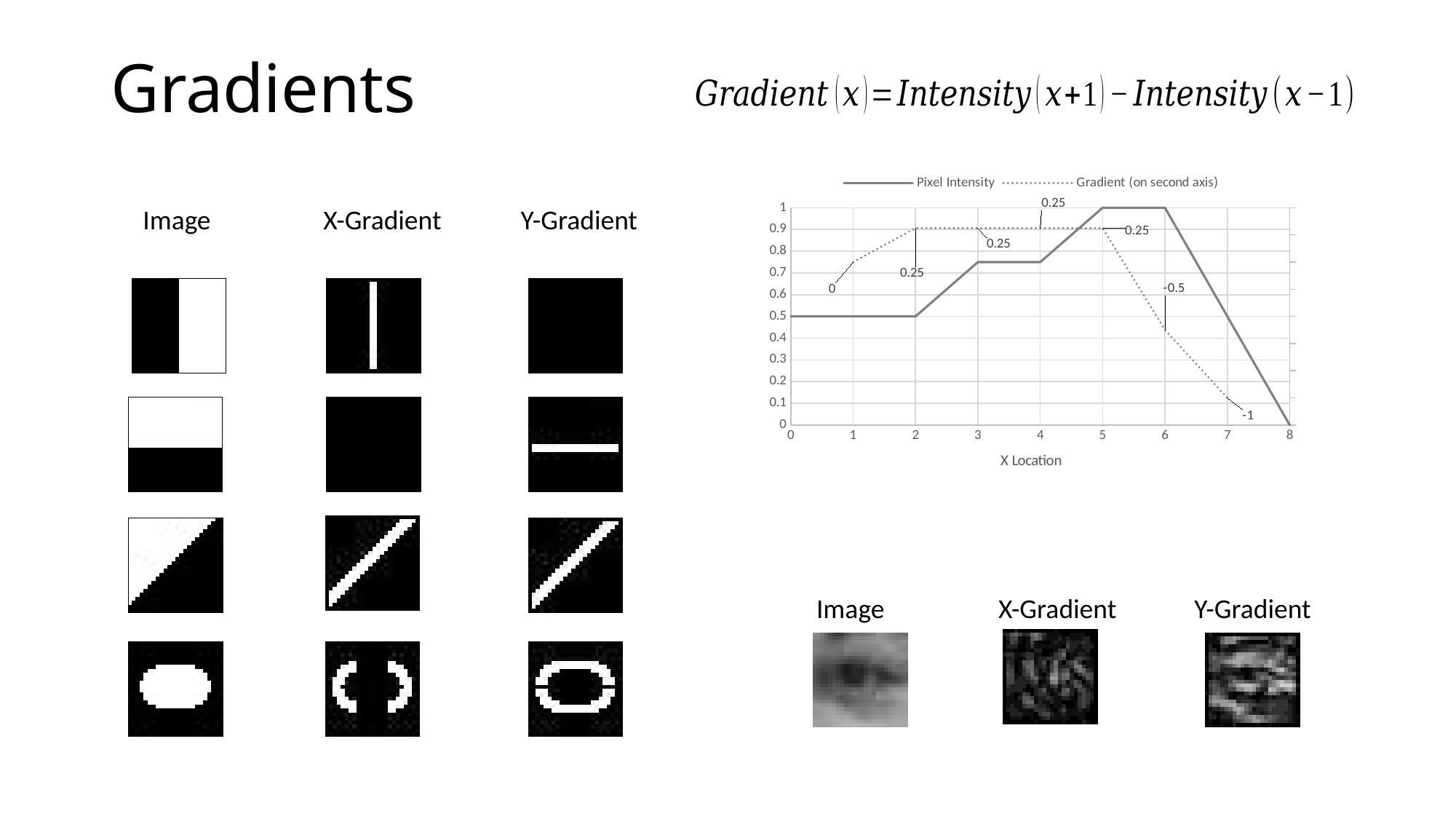
What kind of chart is shown on the slide? line chart Is the Pixel Intensity value at X Location 3 greater or less than 0.6? greater What is the labelled Gradient value at X Location 1? 0 Does the Pixel Intensity line rise or fall between X Location 6 and X Location 8? fall How many series does the chart's legend list? 2 What is the difference between the labelled Gradient values at X Location 2 and X Location 7? 1.25 What is the labelled Gradient value at X Location 6? -0.5 Which series is drawn with a dotted line in the chart? Gradient (on second axis) At which X Location is the labelled Gradient value lowest? 7 What is the labelled Gradient value at X Location 7? -1 What is the title of the chart's x axis? X Location Which is larger, the Gradient value at X Location 6 or at X Location 7? X Location 6